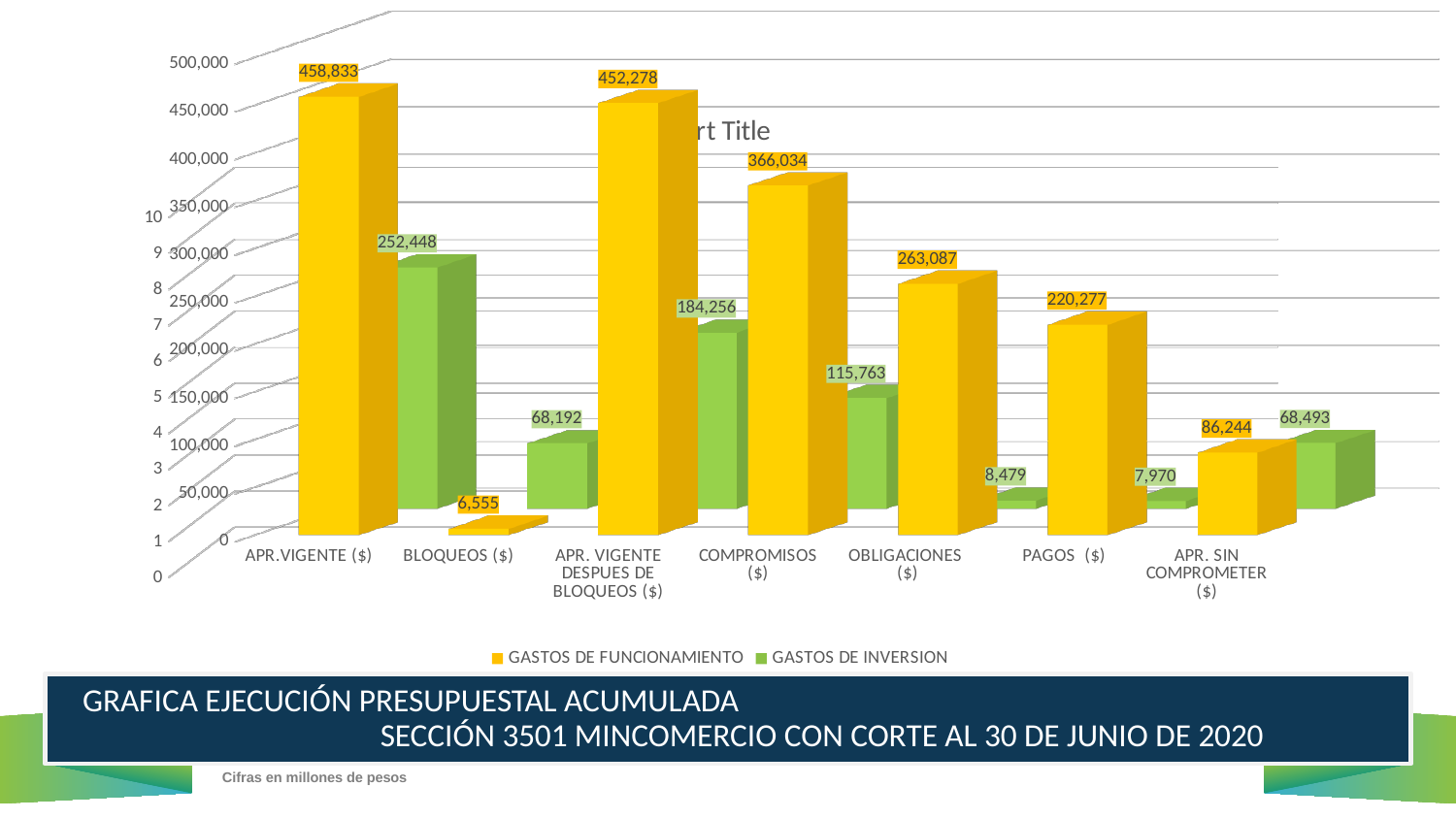
Which category has the highest value for GASTOS DE FUNCIONAMIENTO? APR.VIGENTE ($) What is the value of GASTOS DE FUNCIONAMIENTO for APR.VIGENTE ($)? 458,833 What is the value of GASTOS DE INVERSION for COMPROMISOS ($)? 115,763 How many series does the legend list? 2 What is the value of GASTOS DE INVERSION for BLOQUEOS ($)? 68,192 How many categories are shown on the x axis? 7 What is the value of GASTOS DE FUNCIONAMIENTO for PAGOS ($)? 220,277 What kind of chart is shown on the slide? Bar chart Which is larger for BLOQUEOS ($): GASTOS DE FUNCIONAMIENTO or GASTOS DE INVERSION? GASTOS DE INVERSION Which category has the lowest value for GASTOS DE INVERSION? PAGOS ($) Which series is shown in green in the legend? GASTOS DE INVERSION What is the difference between GASTOS DE FUNCIONAMIENTO and GASTOS DE INVERSION for OBLIGACIONES ($)? 254,608